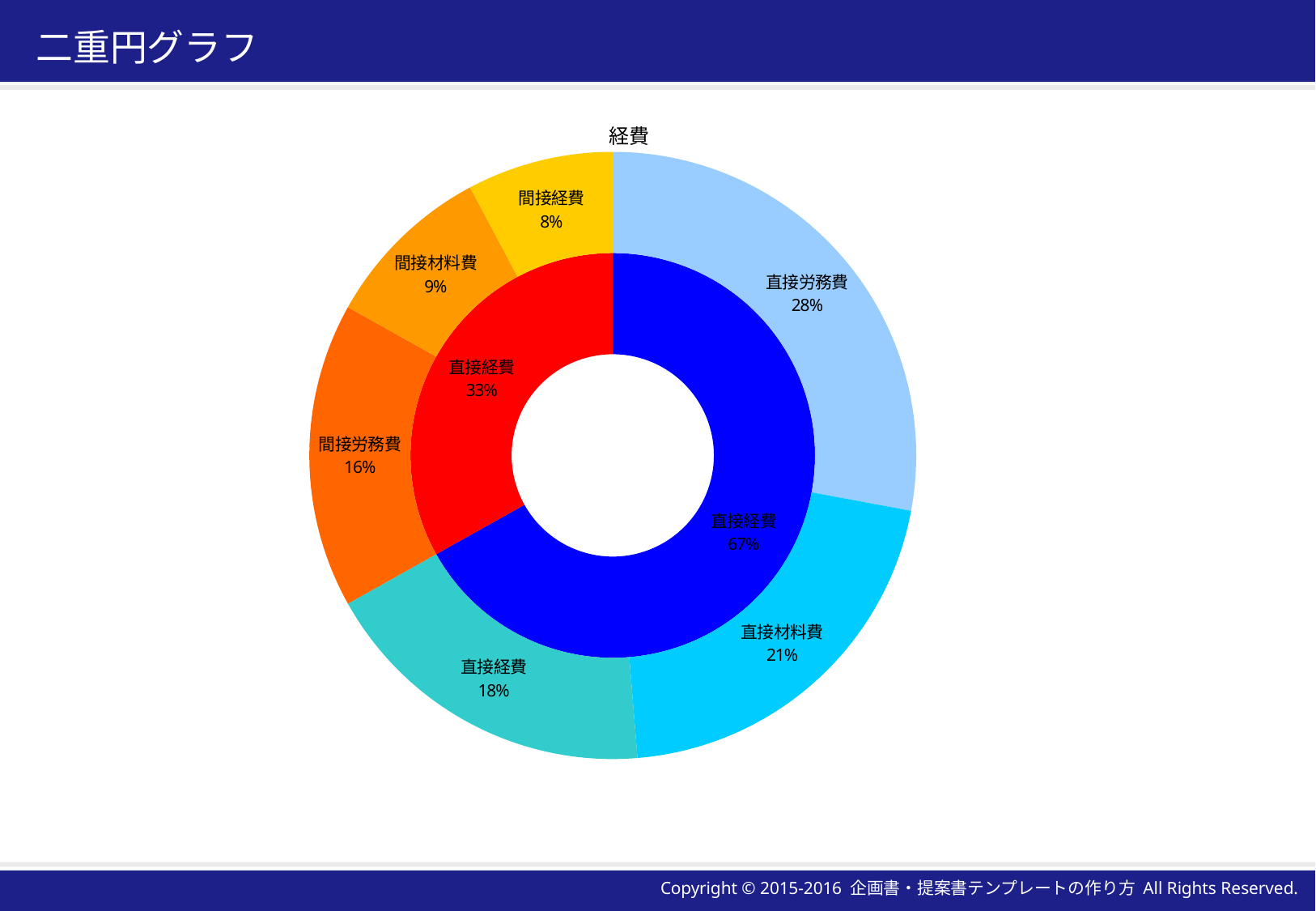
How many segments are in the outer ring? 6 What percentage is shown for 直接材料費 in the outer ring? 21% What kind of chart is shown on the slide? Doughnut chart (double ring) What percentage is shown for 間接材料費 in the outer ring? 9% What percentage is shown for the blue segment of the inner ring? 67% What is the title of the chart? 経費 What percentage is shown for 直接労務費 in the outer ring? 28% What percentage is shown for 間接経費 in the outer ring? 8% What is the difference in percentage points between 直接労務費 and 直接材料費 in the outer ring? 7 Which category in the outer ring has the smallest share? 間接経費 Which category in the outer ring has the largest share? 直接労務費 What percentage is shown for 間接労務費 in the outer ring? 16%